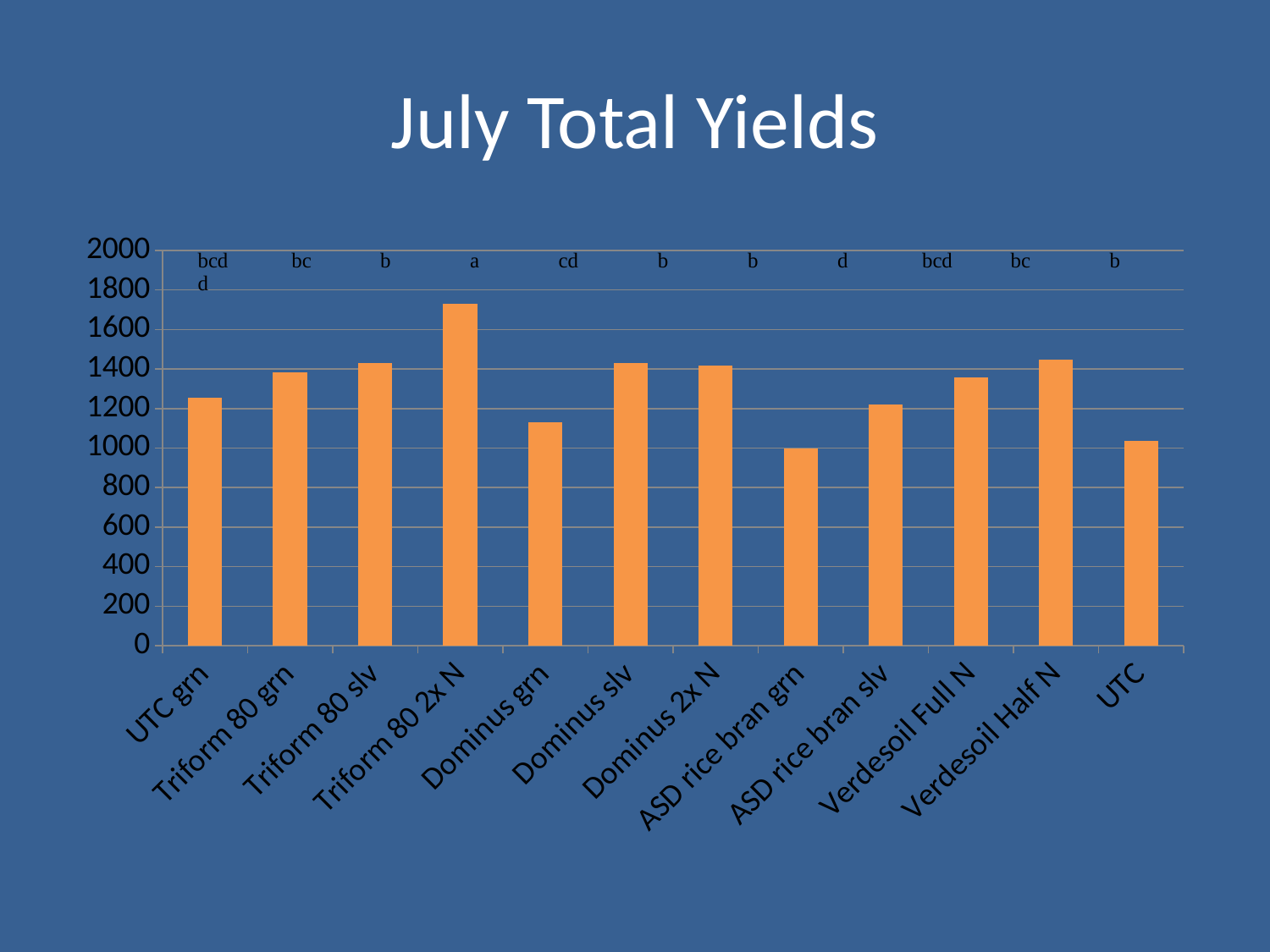
Which category is marked with the letter "a" above its bar? Triform 80 2x N Is the value for UTC greater or less than 1200? less What kind of chart is shown on the slide? bar chart Is the value for UTC grn greater or less than 1200? greater What is the title of the chart? July Total Yields Is the value for Dominus grn greater or less than 1200? less Which is larger, the value for Triform 80 2x N or the value for Dominus grn? Triform 80 2x N Which is larger, the value for Verdesoil Half N or the value for UTC? Verdesoil Half N Which category has the highest July total yield? Triform 80 2x N How many categories are plotted on the x axis? 12